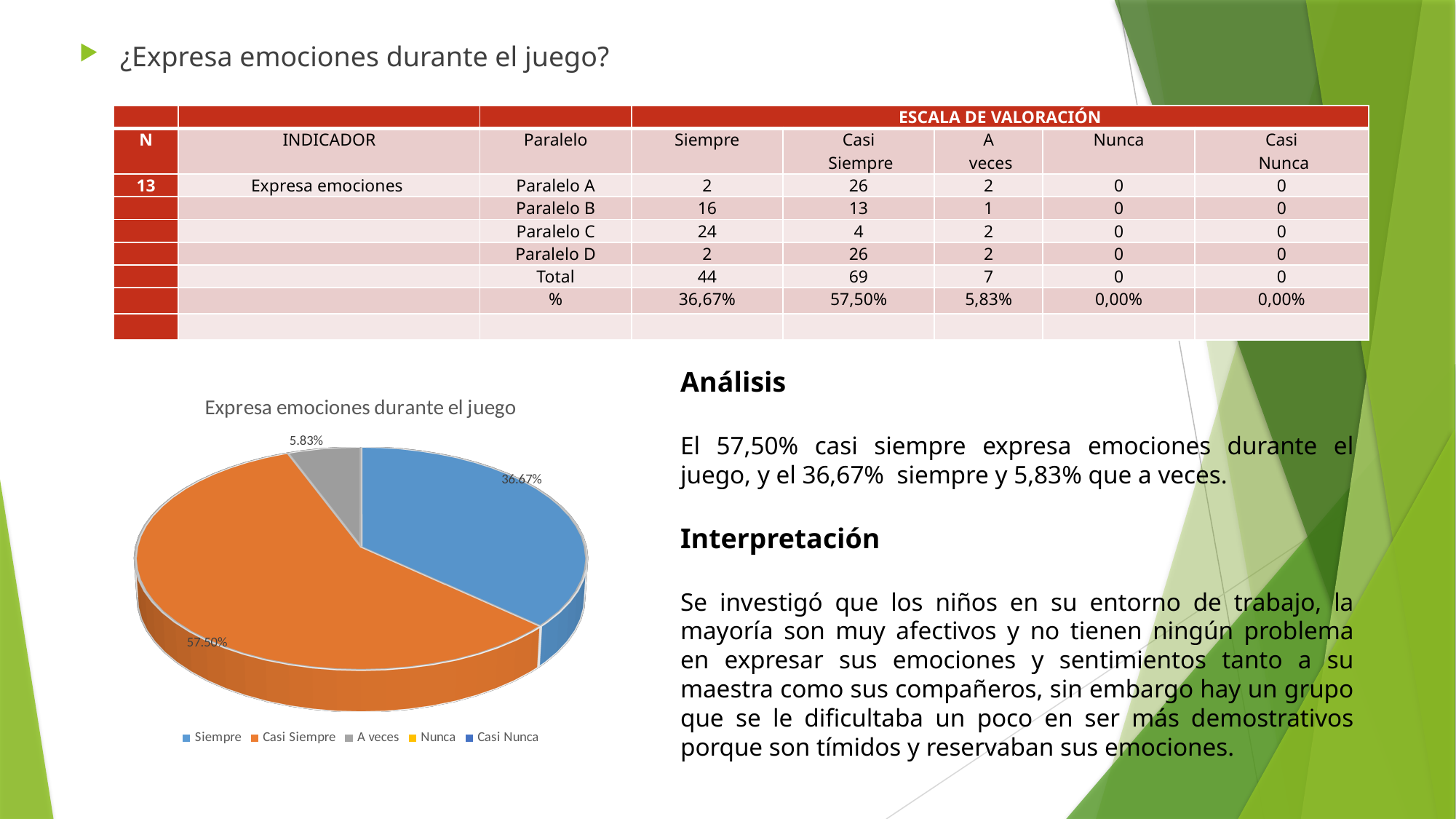
What colour is the Casi Siempre slice in the pie chart? Orange How many entries does the legend of the pie chart list? 5 What share of the pie does the Casi Siempre slice represent? 57.50% What is the title of the pie chart? Expresa emociones durante el juego Which slice is larger, Siempre or Casi Siempre? Casi Siempre What kind of chart is shown on the slide? Pie chart Which of the labelled slices is the smallest? A veces How many slices in the pie chart have a percentage label printed? 3 What is the difference in percentage points between the Casi Siempre slice and the Siempre slice? 20.83 What share of the pie does the A veces slice represent? 5.83% Which category has the largest slice of the pie? Casi Siempre What share of the pie does the Siempre slice represent? 36.67%